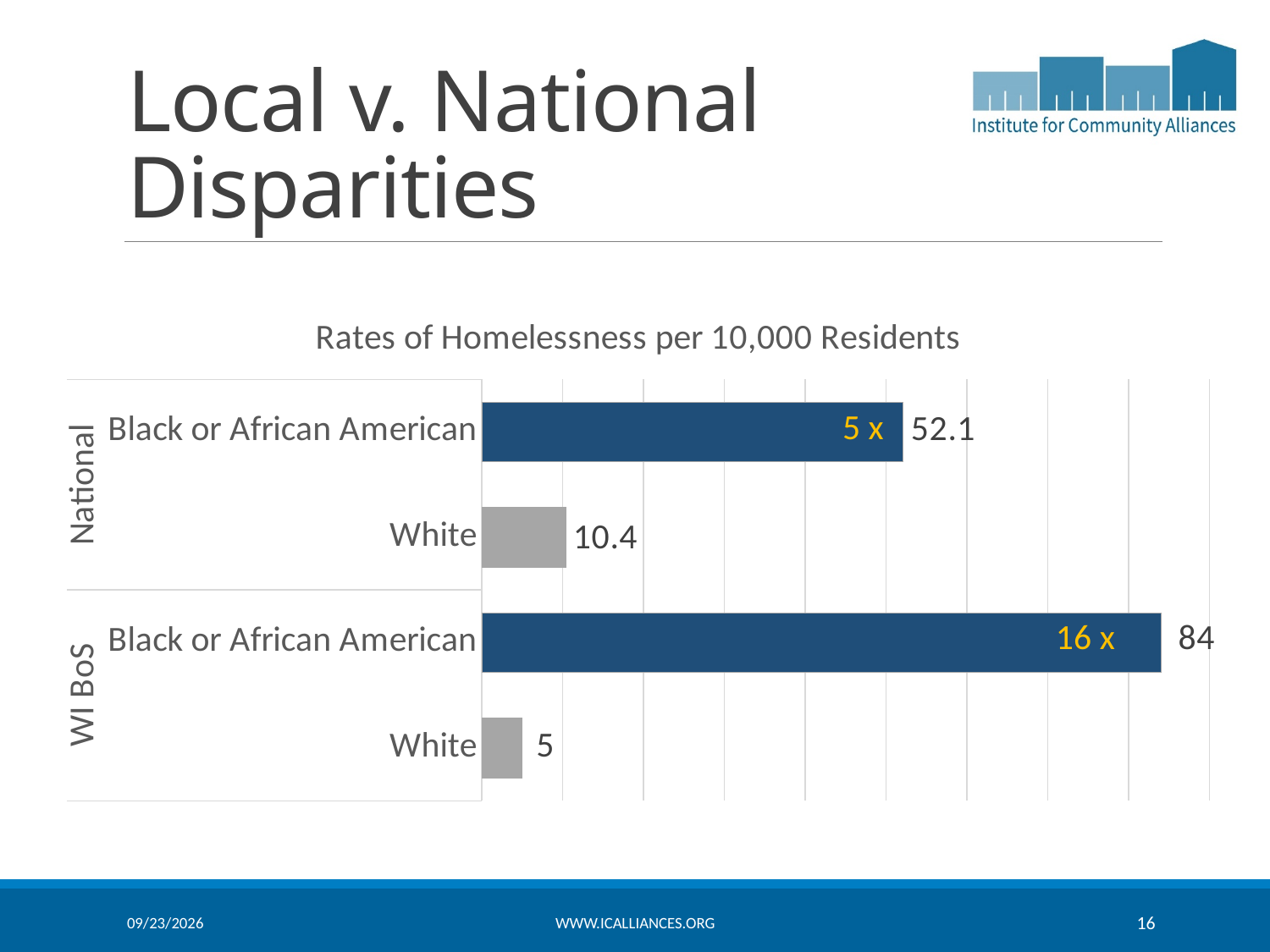
What is the rate of homelessness per 10,000 residents for Black or African American people in WI BoS? 84 What is the difference between the WI BoS and National rates for Black or African American people? 31.9 What is the rate of homelessness per 10,000 residents for White people in WI BoS? 5 Which is larger: the National rate for White people or the WI BoS rate for White people? National rate for White people What is the rate of homelessness per 10,000 residents for White people at the National level? 10.4 How many bars are plotted in the chart? 4 Which bar has the lowest rate of homelessness per 10,000 residents? WI BoS White What is the difference between the National rates for Black or African American and White people? 41.7 What multiplier label is shown on the WI BoS Black or African American bar? 16 x What is the rate of homelessness per 10,000 residents for Black or African American people at the National level? 52.1 Which bar has the highest rate of homelessness per 10,000 residents? WI BoS Black or African American What kind of chart is shown on the slide? Bar chart